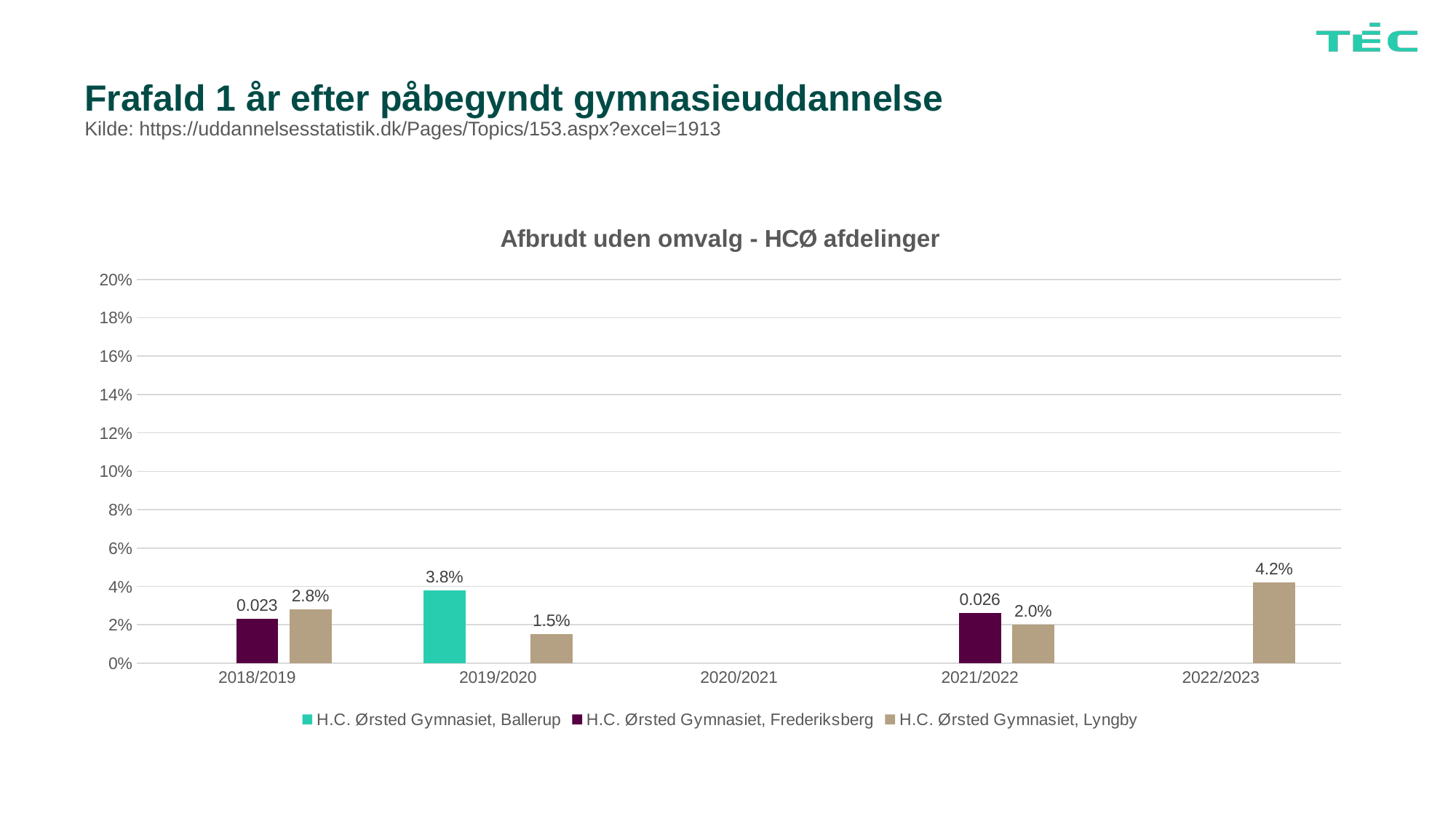
What is the value for H.C. Ørsted Gymnasiet, Lyngby in 2022/2023? 4.2% Which is larger in 2019/2020: the value for Ballerup or the value for Lyngby? Ballerup In which year does H.C. Ørsted Gymnasiet, Lyngby have its lowest value? 2019/2020 How many series does the legend list? 3 What data label is shown for H.C. Ørsted Gymnasiet, Frederiksberg in 2021/2022? 0.026 What is the difference between the Lyngby values for 2018/2019 and 2019/2020? 1.3 percentage points In which year does H.C. Ørsted Gymnasiet, Lyngby have its highest value? 2022/2023 What is the value for H.C. Ørsted Gymnasiet, Lyngby in 2019/2020? 1.5% What is the value for H.C. Ørsted Gymnasiet, Ballerup in 2019/2020? 3.8% What kind of chart is shown on the slide? Bar chart How many school years are shown on the x axis? 5 Is the value for H.C. Ørsted Gymnasiet, Lyngby in 2022/2023 greater or less than 4%? greater